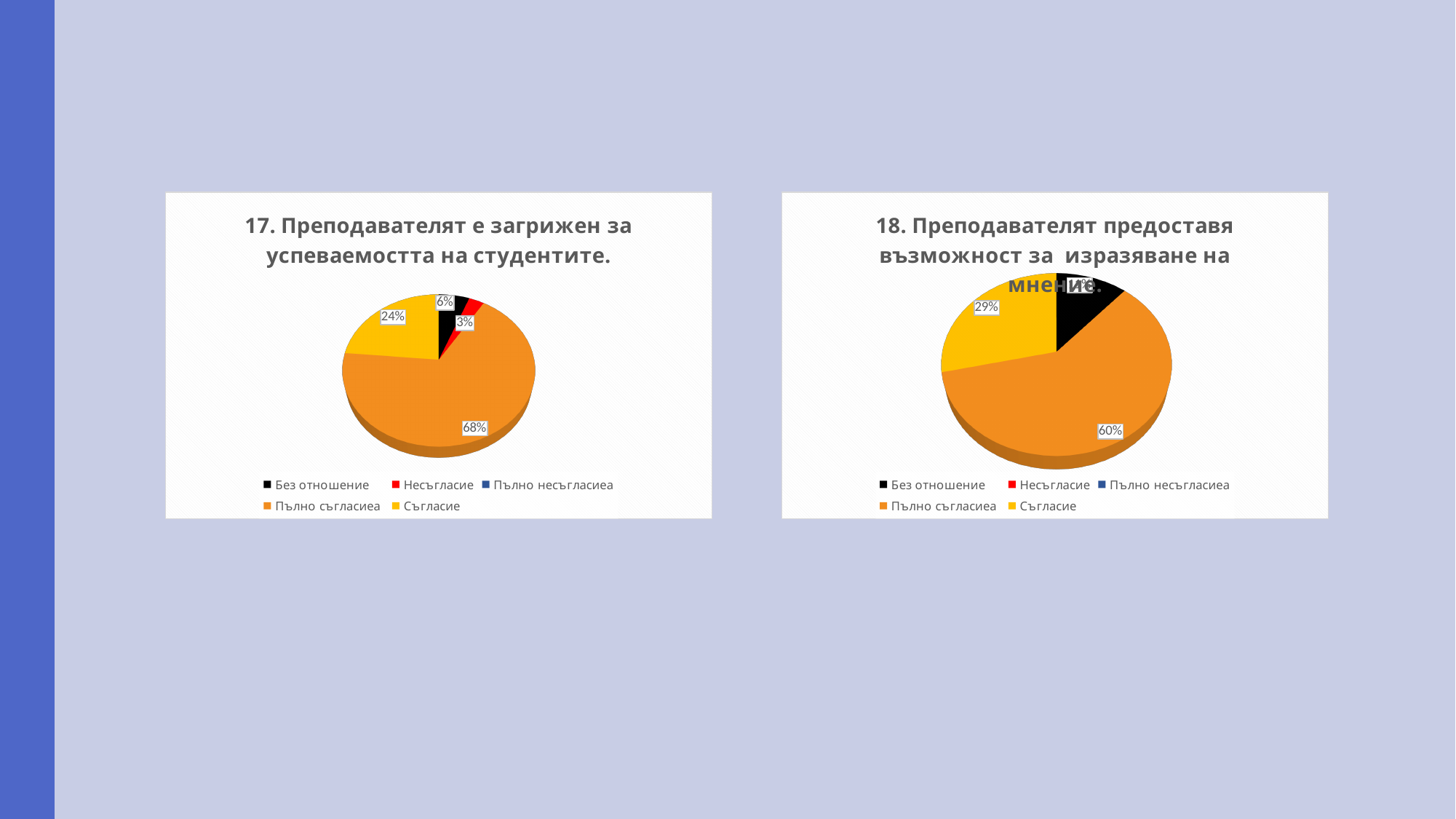
How many entries does the legend of the right chart (question 18) list? 5 In the left chart (question 17), which category has the largest slice? Пълно съгласиеа In the chart titled "17. Преподавателят е загрижен за успеваемостта на студентите.", what share does "Съгласие" have? 24% In the chart titled "17. Преподавателят е загрижен за успеваемостта на студентите.", what share does "Без отношение" have? 6% In the chart titled "17. Преподавателят е загрижен за успеваемостта на студентите.", what share does "Пълно съгласиеа" have? 68% What type of chart is the left chart (question 17)? Pie chart In the chart titled "17. Преподавателят е загрижен за успеваемостта на студентите.", what share does "Несъгласие" have? 3% In the right chart (question 18), which is larger, the slice for "Пълно съгласиеа" or the slice for "Съгласие"? Пълно съгласиеа In the left chart (question 17), what is the difference between the shares of "Пълно съгласиеа" and "Съгласие"? 44% In the chart titled "18. Преподавателят предоставя възможност за изразяване на мнение.", what share does "Съгласие" have? 29% In the right chart (question 18), what is the difference between the shares of "Пълно съгласиеа" and "Съгласие"? 31% In the chart titled "18. Преподавателят предоставя възможност за изразяване на мнение.", what share does "Пълно съгласиеа" have? 60%